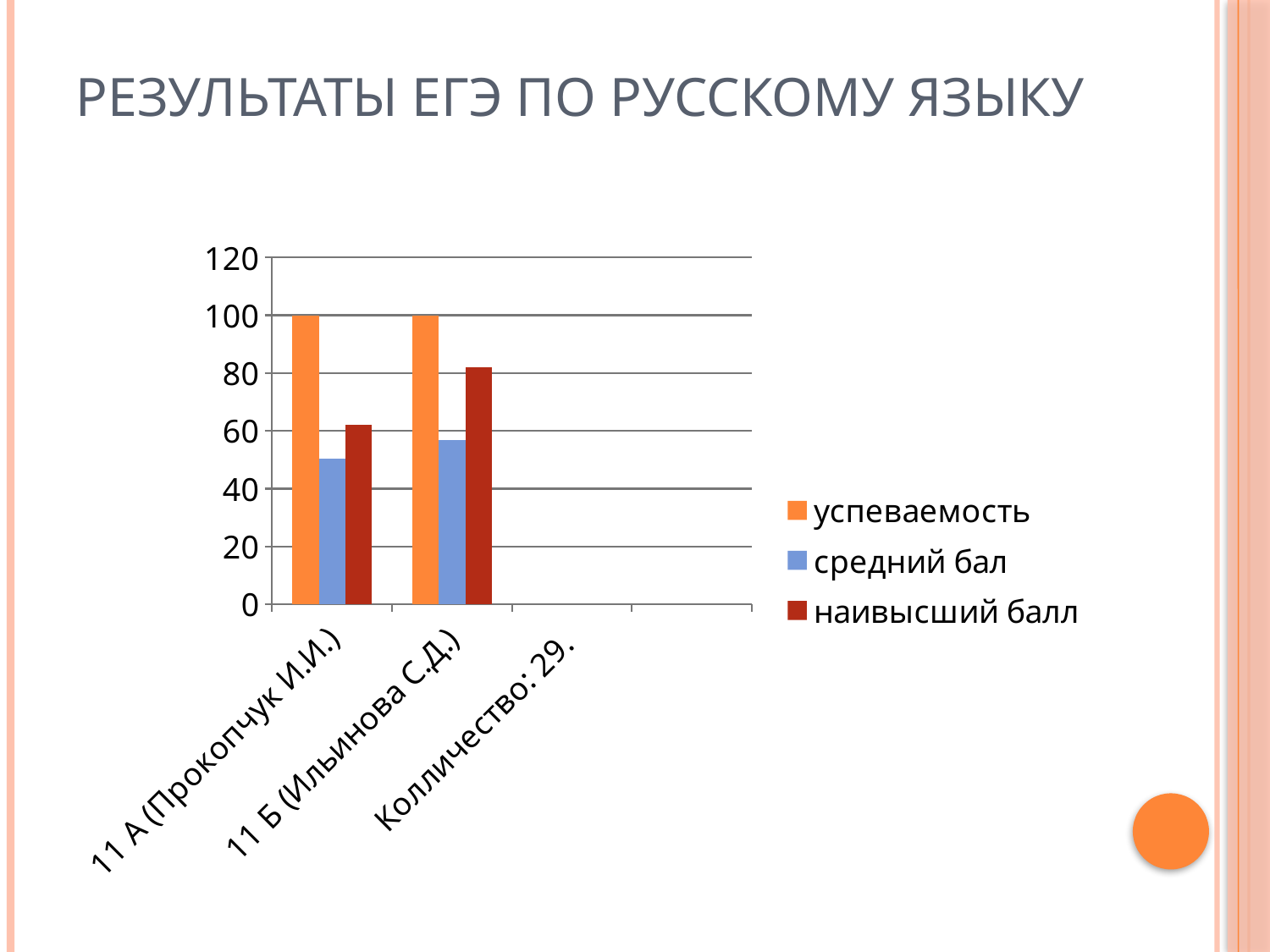
How many series does the legend list? 3 Is the value of средний бал for 11 А (Прокопчук И.И.) greater or less than 60? less What is the title of the slide containing the chart? Результаты ЕГЭ по русскому языку Is the value of наивысший балл for 11 Б (Ильинова С.Д.) greater or less than 80? greater Which series has the highest value for 11 Б (Ильинова С.Д.)? успеваемость What is the value of успеваемость for 11 А (Прокопчук И.И.)? 100 Which series has the lowest value for 11 А (Прокопчук И.И.)? средний бал What type of chart is shown on the slide? bar chart Is the value of средний бал for 11 Б (Ильинова С.Д.) greater or less than 40? greater Which class has the higher наивысший балл, 11 А (Прокопчук И.И.) or 11 Б (Ильинова С.Д.)? 11 Б (Ильинова С.Д.) What is the value of успеваемость for 11 Б (Ильинова С.Д.)? 100